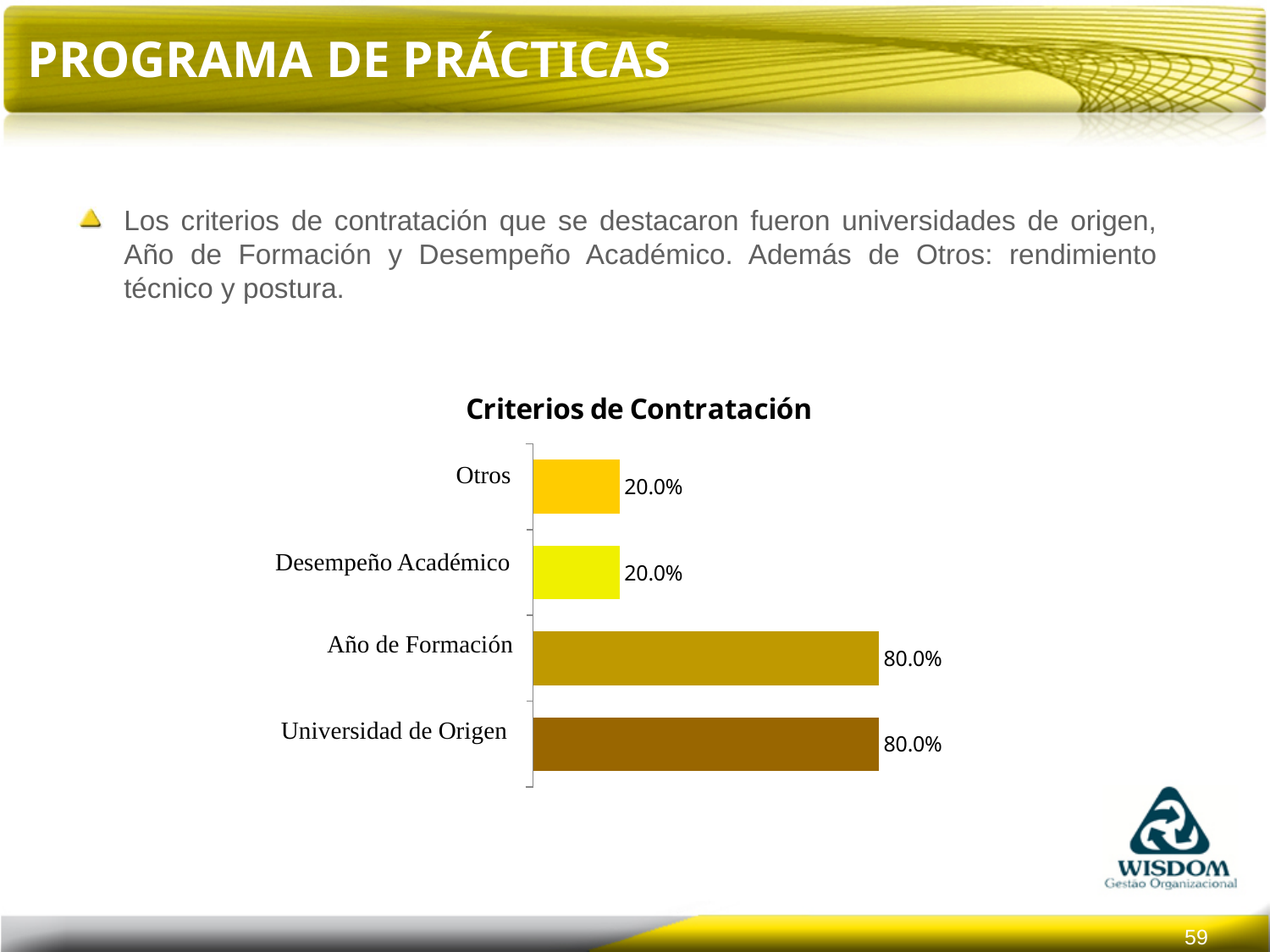
What is the difference between the values for Universidad de Origen and Otros? 60.0% How many categories are shown in the chart? 4 What is the value for Universidad de Origen? 80.0% What is the value for Año de Formación? 80.0% Which categories share the highest value in the chart? Universidad de Origen and Año de Formación What is the title of the chart? Criterios de Contratación Which categories share the lowest value in the chart? Otros and Desempeño Académico What is the value for Otros in the Criterios de Contratación chart? 20.0% What kind of chart is shown on the slide? Bar chart Are the bars in the chart horizontal or vertical? Horizontal What is the value for Desempeño Académico? 20.0% Which is larger, the value for Año de Formación or the value for Desempeño Académico? Año de Formación